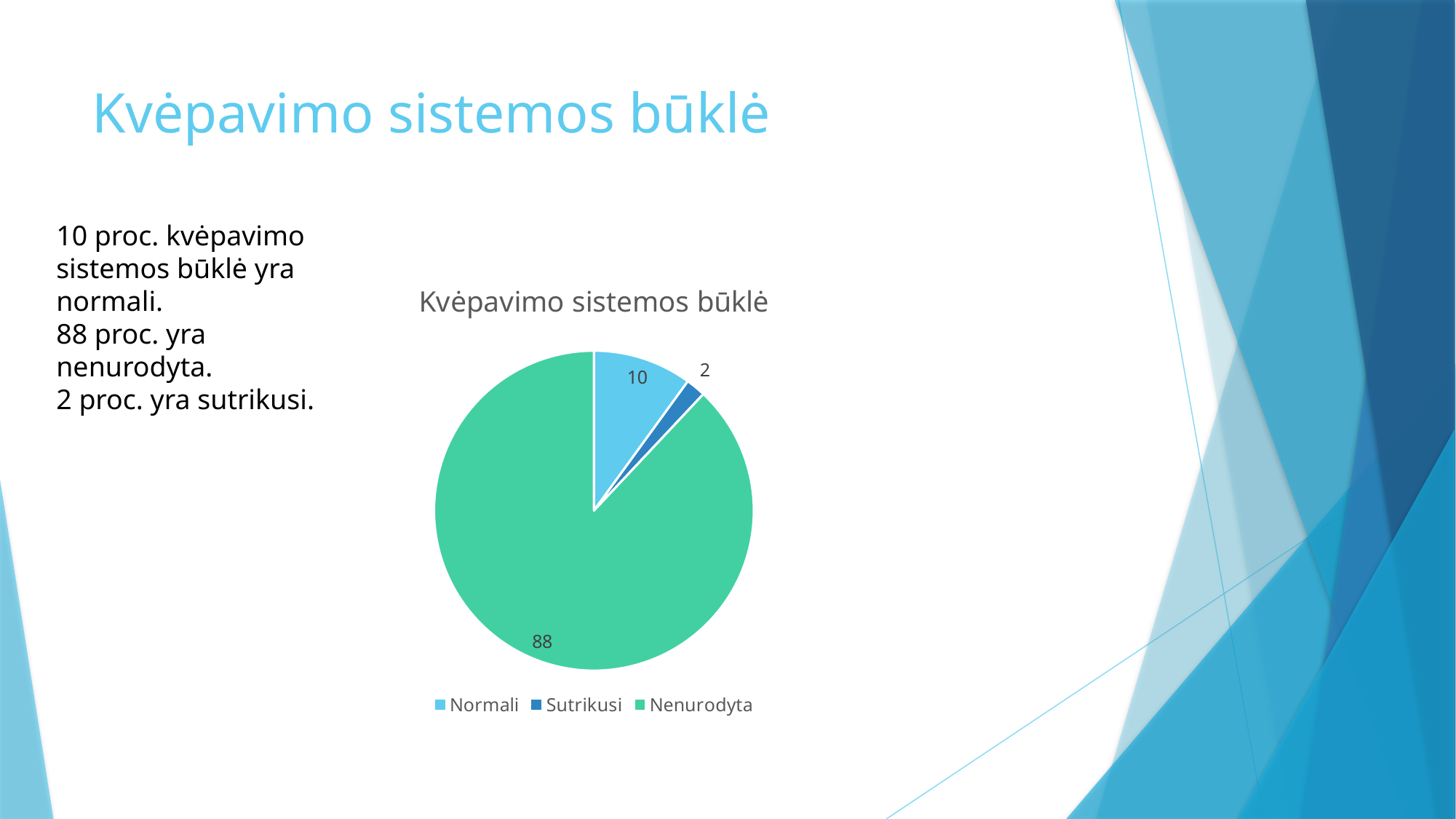
What is the value for Sutrikusi? 2 What share of the pie does Nenurodyta represent? 88% Which category has the smallest slice? Sutrikusi What is the value for Normali? 10 How many categories does the pie chart have? 3 What is the title of the chart? Kvėpavimo sistemos būklė What is the value for Nenurodyta? 88 What is the difference between the values for Nenurodyta and Normali? 78 What type of chart is shown on the slide? pie chart What is the difference between the values for Normali and Sutrikusi? 8 Which is larger, the value for Normali or the value for Sutrikusi? Normali Which category has the largest slice? Nenurodyta